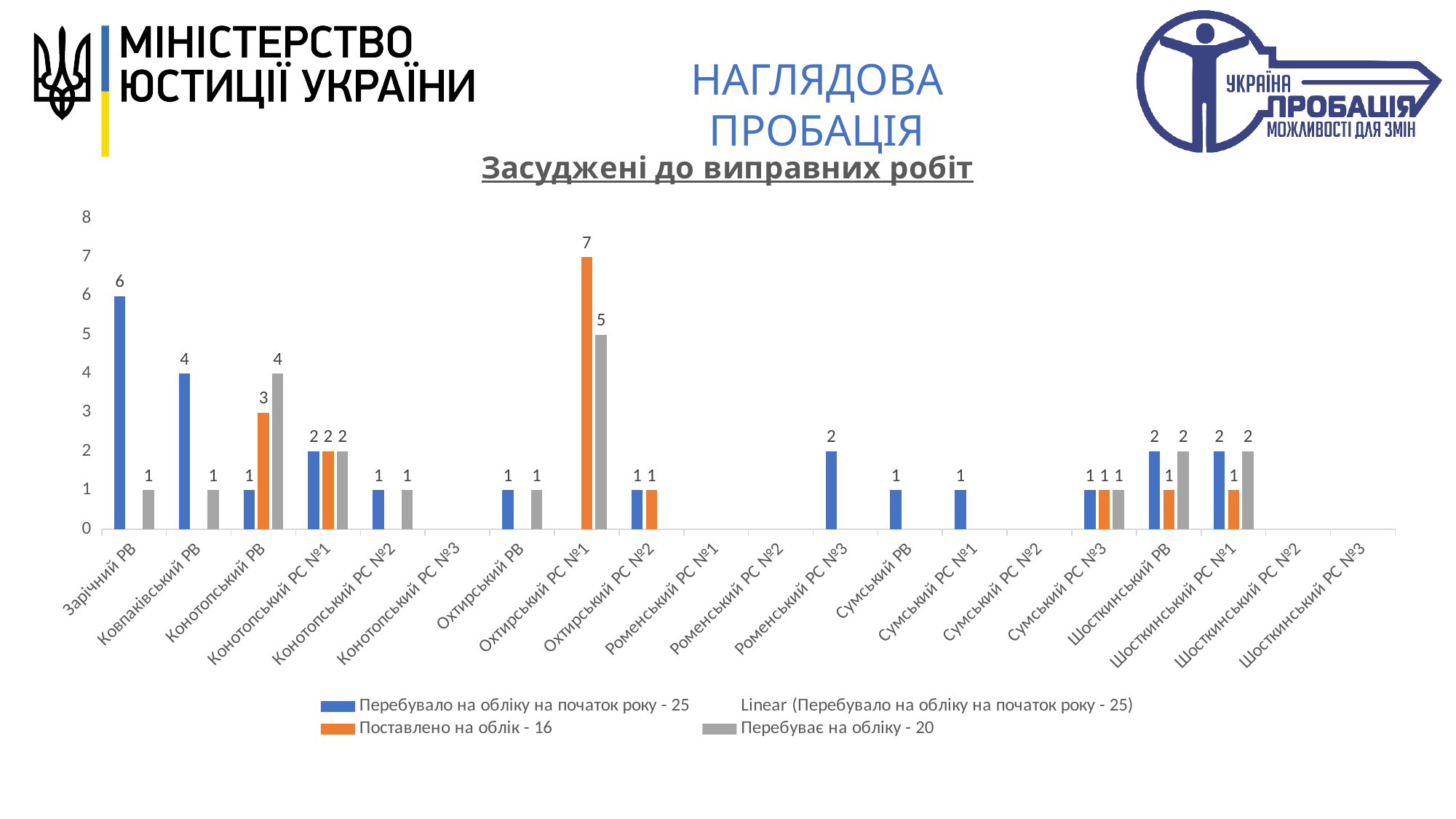
How many categories are shown on the x axis of the chart? 20 Which is larger for Ковпаківський РВ: 'Перебувало на обліку на початок року' or 'Перебуває на обліку'? Перебувало на обліку на початок року What is the title of the chart? Засуджені до виправних робіт What is the value of 'Поставлено на облік' for Охтирський РС №1? 7 What is the value of 'Перебуває на обліку' for Конотопський РВ? 4 Which category has the highest value for 'Перебувало на обліку на початок року'? Зарічний РВ How many entries does the chart legend list? 4 What is the value of 'Перебувало на обліку на початок року' for Зарічний РВ? 6 Which category has the highest value for 'Перебуває на обліку'? Охтирський РС №1 What is the value of 'Перебувало на обліку на початок року' for Роменський РС №3? 2 What type of chart is shown on the slide? Bar chart What is the difference between 'Поставлено на облік' and 'Перебуває на обліку' for Охтирський РС №1? 2